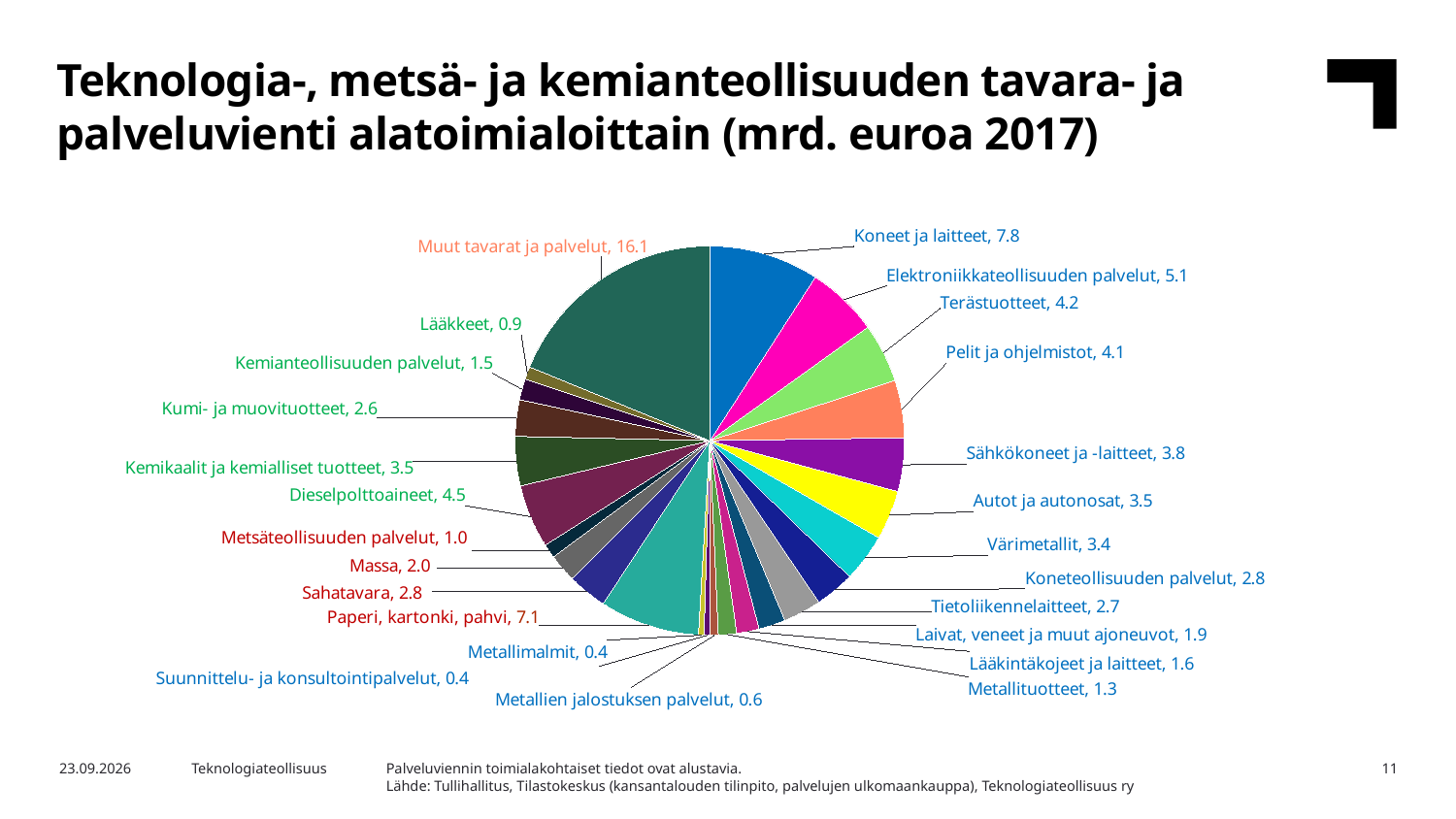
What type of chart is shown on the slide? Pie chart Which category has the largest slice of the pie? Muut tavarat ja palvelut What is the difference between Muut tavarat ja palvelut and Koneet ja laitteet? 8.3 What unit and year does the slide title give for the values? mrd. euroa 2017 What is the value for Lääkintäkojeet ja laitteet? 1.6 What is the value for Kemianteollisuuden palvelut? 1.5 Which is larger, Pelit ja ohjelmistot or Sähkökoneet ja -laitteet? Pelit ja ohjelmistot How many slices does the pie chart have? 25 What is the value for Koneet ja laitteet? 7.8 What is the value for Paperi, kartonki, pahvi? 7.1 What is the value for Dieselpolttoaineet? 4.5 What is the difference between Koneet ja laitteet and Paperi, kartonki, pahvi? 0.7